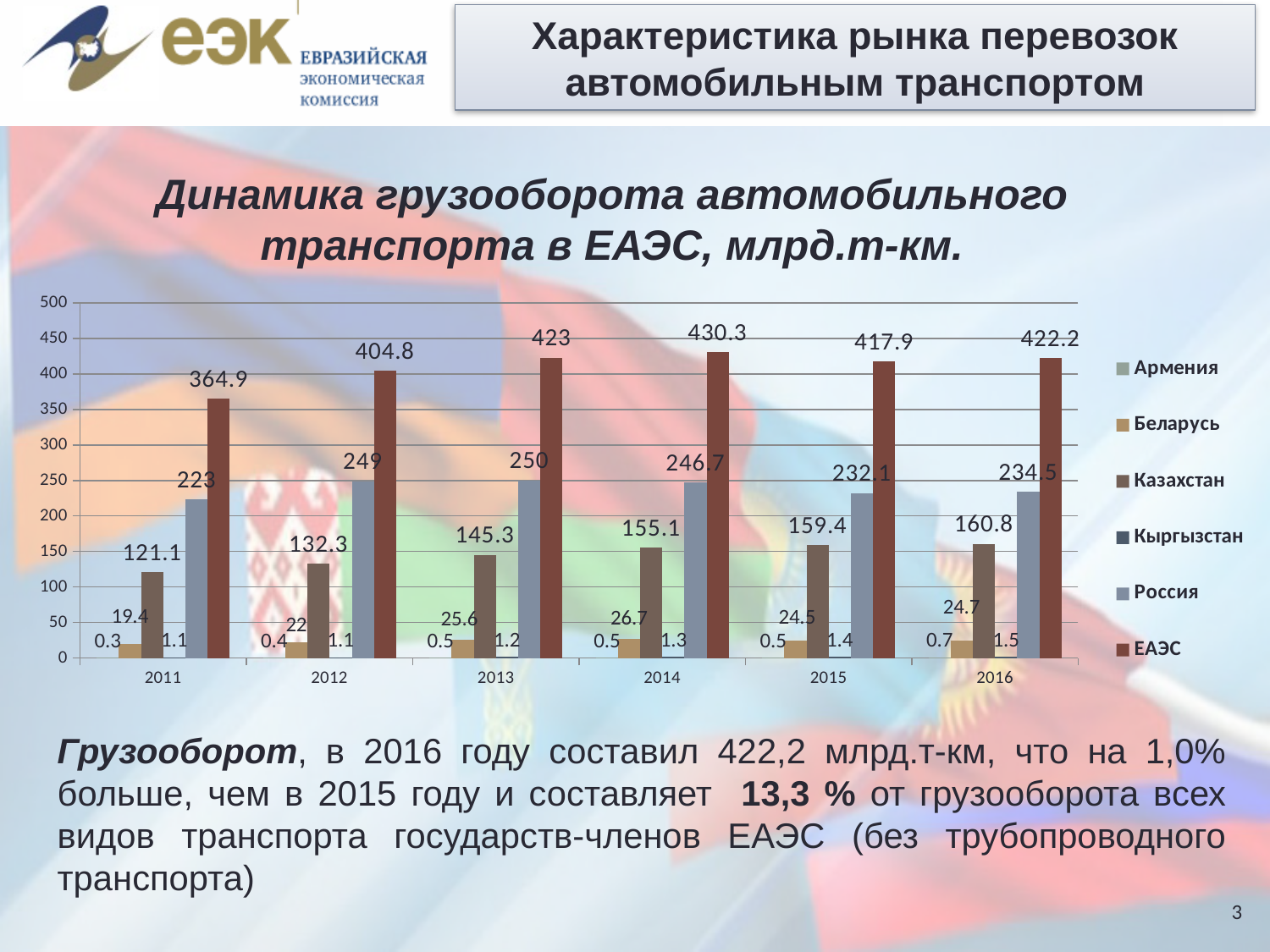
What is the value for ЕАЭС in 2014? 430.3 What is the value for Россия in 2012? 249 What is the value for Беларусь in 2011? 19.4 What type of chart is shown on the slide? bar chart How many series does the legend list? 6 In which year is the ЕАЭС value the highest? 2014 Which is larger: the value for Россия in 2013 or in 2016? 2013 How many years are shown along the x axis? 6 In which year is the ЕАЭС value the lowest? 2011 What is the difference between the ЕАЭС values in 2016 and 2015? 4.3 What is the value for Казахстан in 2016? 160.8 Does the value for Казахстан rise or fall from 2011 to 2016? rise